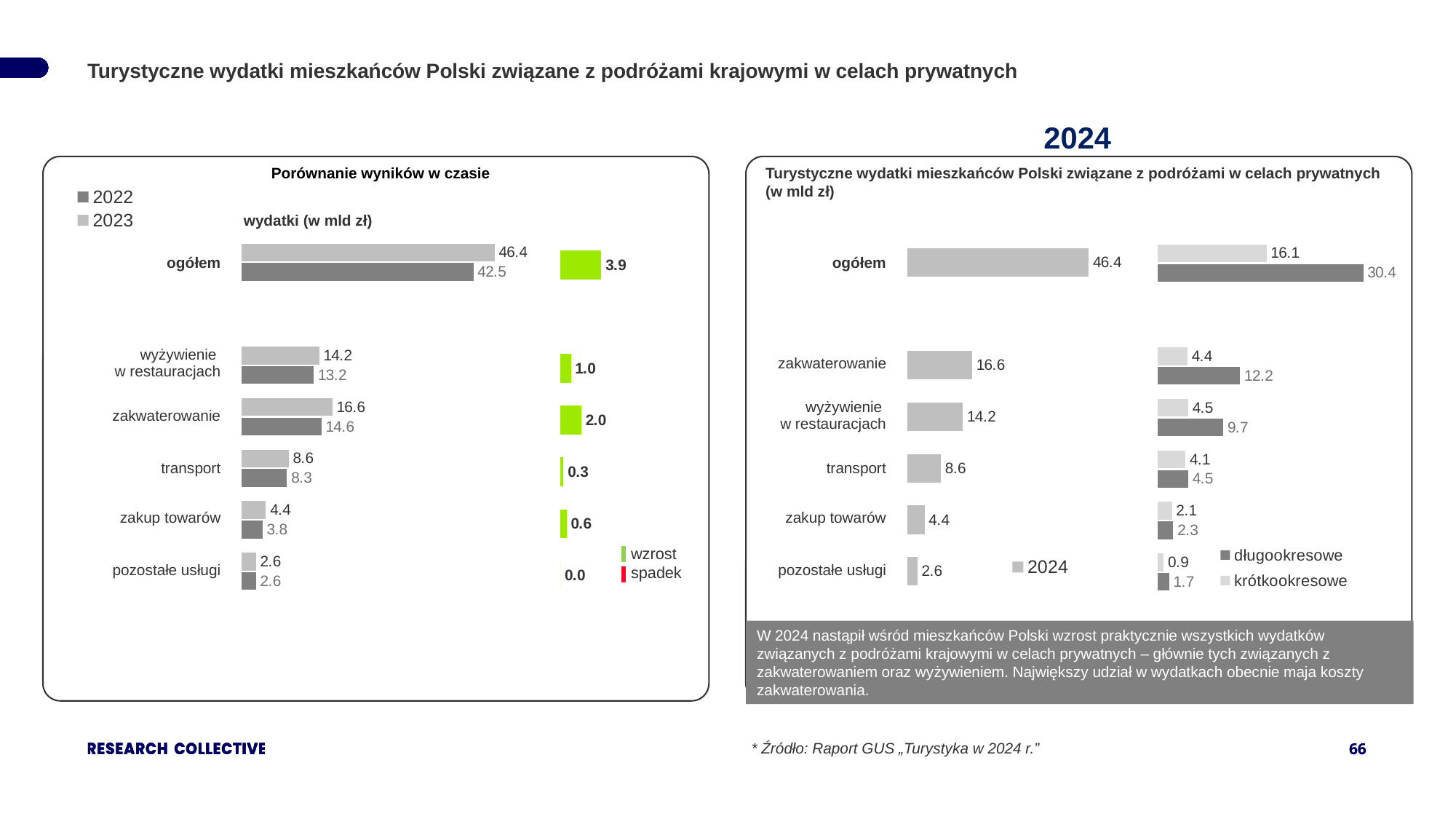
In the right chart for 2024, what is the krótkookresowe value for wyżywienie w restauracjach? 4.5 In the right chart for 2024, what is the długookresowe value for ogółem? 30.4 In the left chart 'Porównanie wyników w czasie', what is the 2023 value for ogółem? 46.4 In the right chart for 2024, what is the difference between the długookresowe and krótkookresowe values for zakwaterowanie? 7.8 In the left chart 'Porównanie wyników w czasie', what is the change (green bar) shown for zakwaterowanie? 2.0 In the right chart for 2024, which category other than ogółem has the lowest 2024 value? pozostałe usługi In the left chart 'Porównanie wyników w czasie', what is the 2022 value for zakwaterowanie? 14.6 In the left chart 'Porównanie wyników w czasie', what is the difference between the 2023 and 2022 values for zakup towarów? 0.6 In the left chart 'Porównanie wyników w czasie', which category other than ogółem has the highest 2023 value? zakwaterowanie In the left chart 'Porównanie wyników w czasie', how many series does the legend list? 2 What type of chart is used in the right panel for 2024? bar chart In the right chart for 2024, which is larger for transport: długookresowe or krótkookresowe? długookresowe